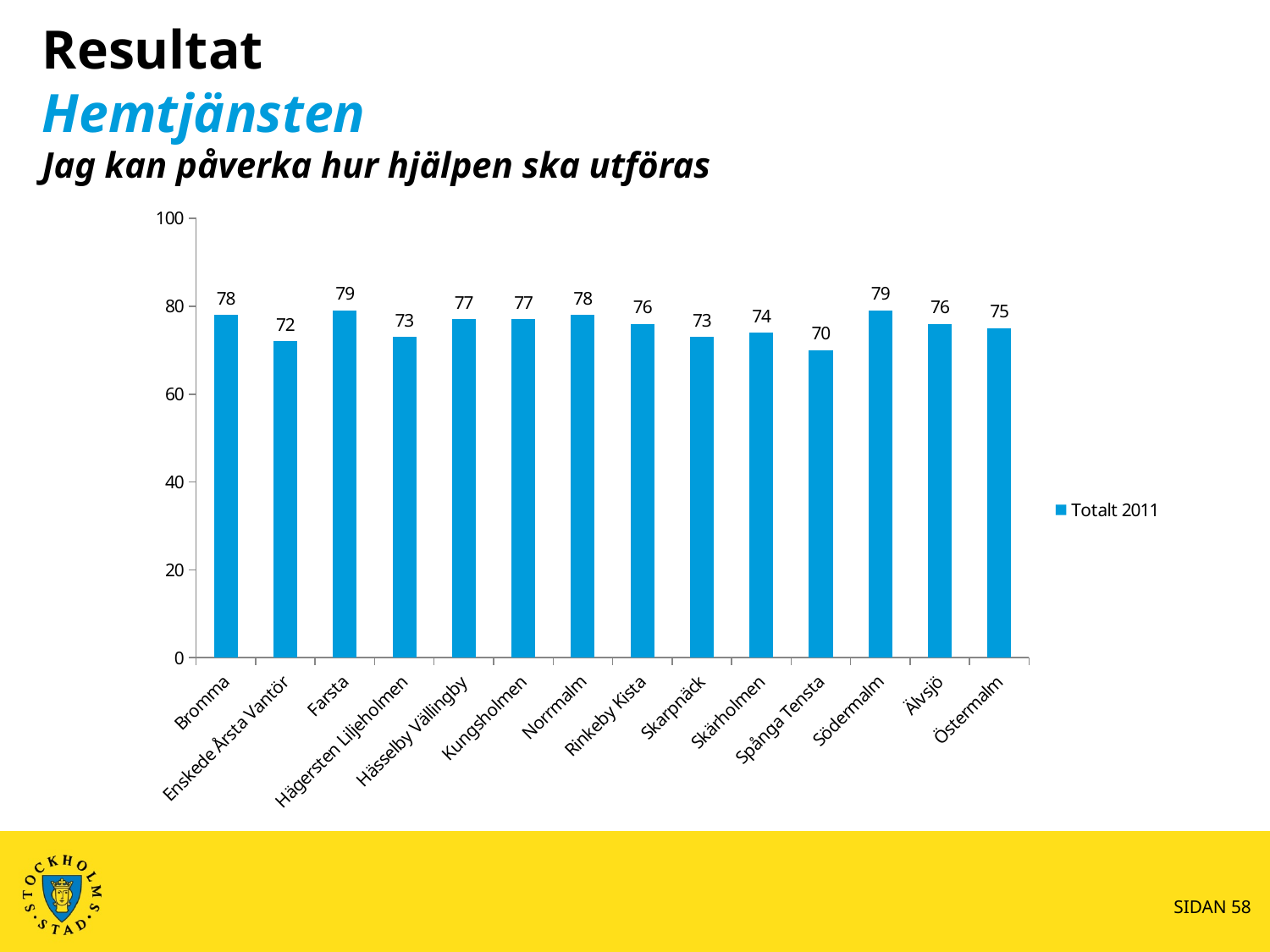
How many series does the legend list? 1 What is the value for Spånga Tensta? 70 Which category has the lowest value? Spånga Tensta What is the legend entry for the series? Totalt 2011 What is the difference between the values for Farsta and Enskede Årsta Vantör? 7 Is the value for Södermalm greater or less than 60? greater How many categories are shown on the x axis? 14 What is the value for Bromma? 78 What is the value for Östermalm? 75 Which is larger, the value for Skärholmen or the value for Rinkeby Kista? Rinkeby Kista What is the value for Hässelby Vällingby? 77 What kind of chart is shown on the slide? bar chart